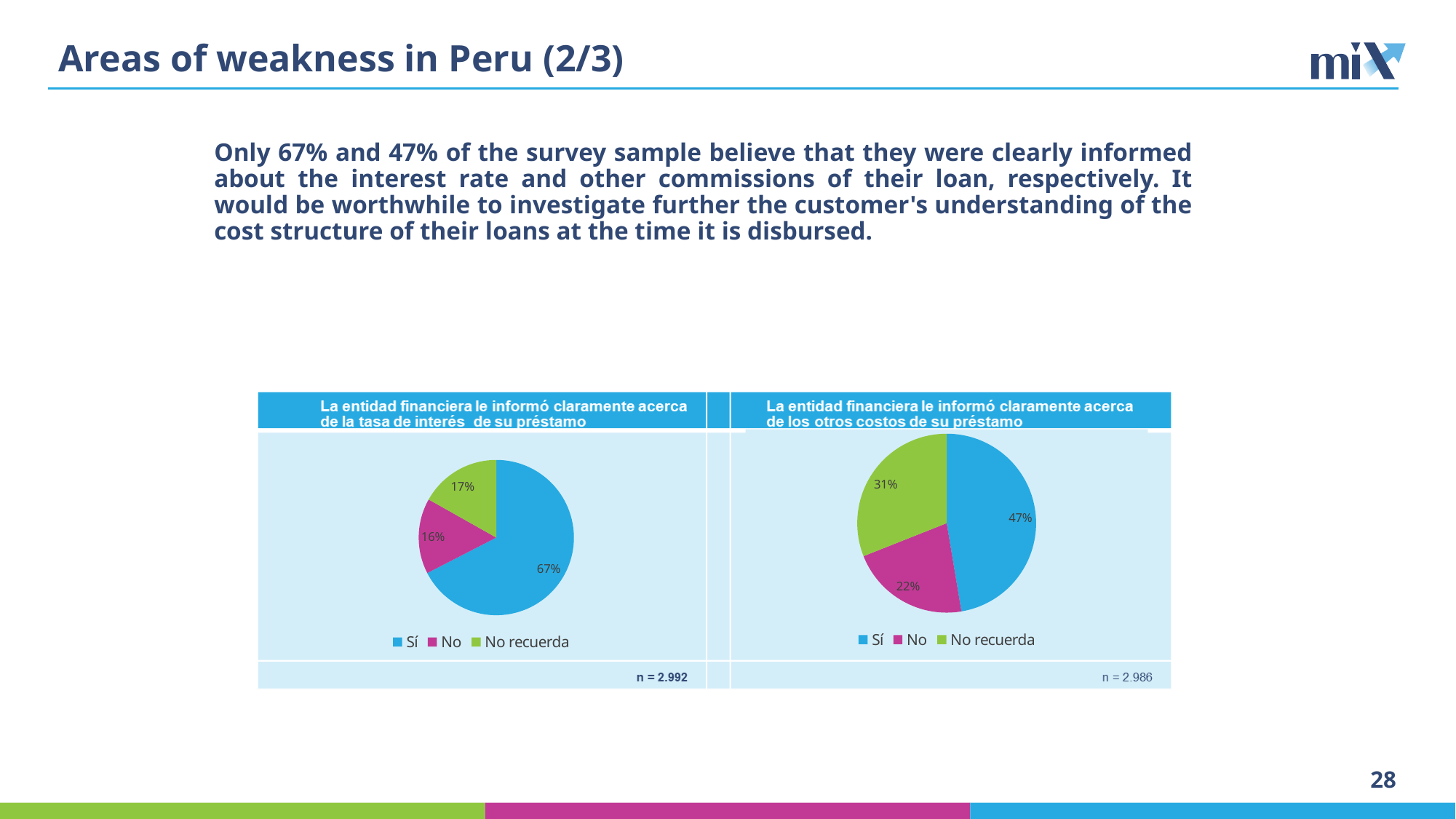
How many slices does the left pie chart (tasa de interés) have? 3 In the right pie chart (otros costos), what share of respondents answered No recuerda? 31% Is the No recuerda share larger in the left pie chart or the right pie chart? Right pie chart How many entries does the legend of the right pie chart list? 3 In the left pie chart (tasa de interés), what share of respondents answered Sí? 67% In the right pie chart (otros costos), what share of respondents answered No? 22% What is the difference between the Sí share in the left pie chart and the Sí share in the right pie chart? 20 percentage points What is the sample size (n) shown under the left pie chart? n = 2.992 In the left pie chart (tasa de interés), which response has the smallest share? No What type of chart is used on this slide? Pie chart In the left pie chart (tasa de interés), what share of respondents answered No? 16% In the right pie chart (otros costos), which response has the largest share? Sí